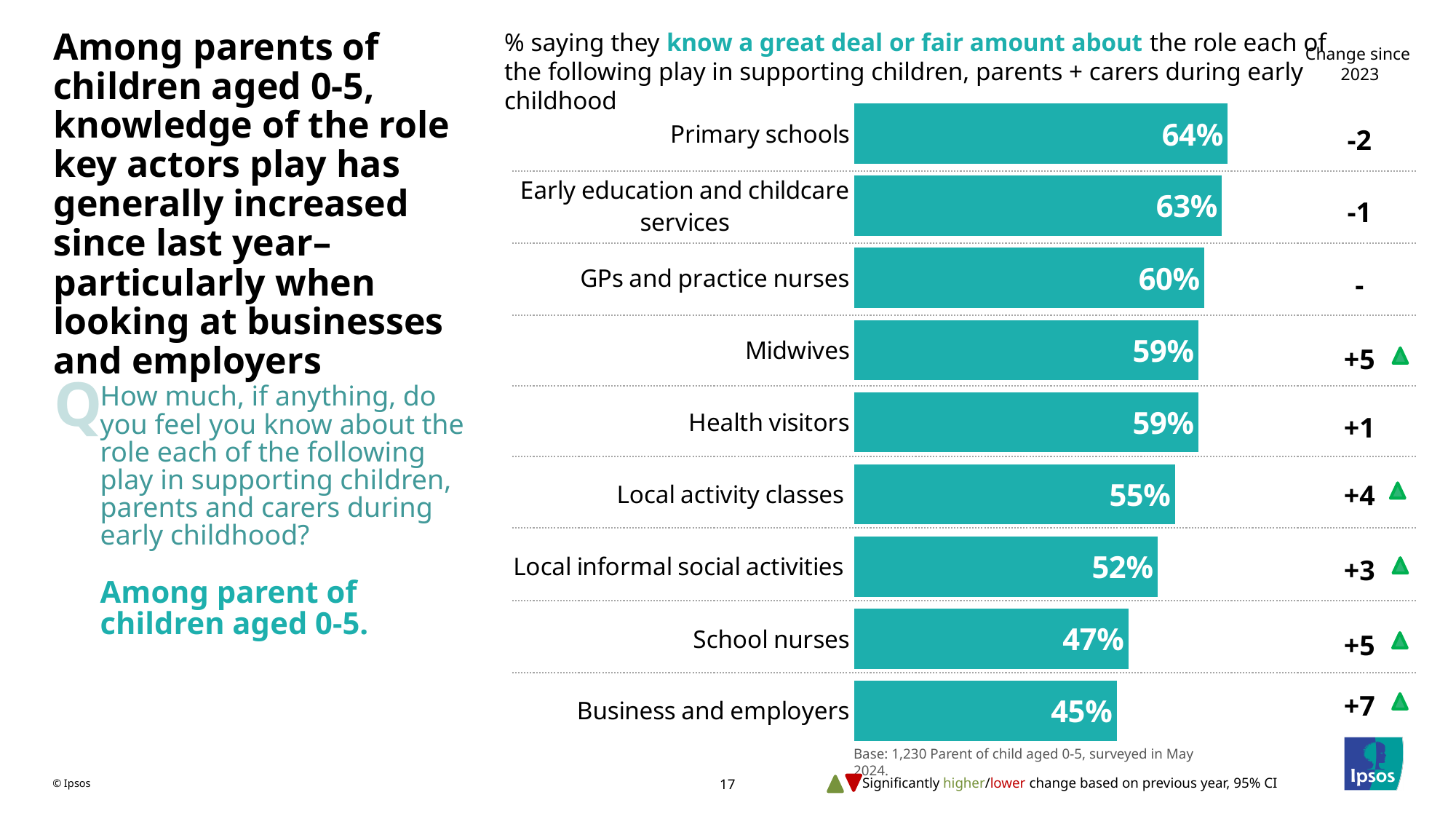
Which category has the highest percentage? Primary schools Which category has the lowest percentage? Business and employers What is the difference between the values for GPs and practice nurses and School nurses? 13 percentage points What kind of chart is shown on the slide? Bar chart What percentage of parents say they know a great deal or fair amount about the role of Primary schools? 64% What is the change since 2023 shown for Business and employers? +7 Which is larger, the value for Local informal social activities or the value for School nurses? Local informal social activities What is the value shown for Business and employers? 45% What is the change since 2023 shown for Midwives? +5 How many categories are shown in the bar chart? 9 What is the difference between the values for Primary schools and Business and employers? 19 percentage points What is the value shown for Local activity classes? 55%